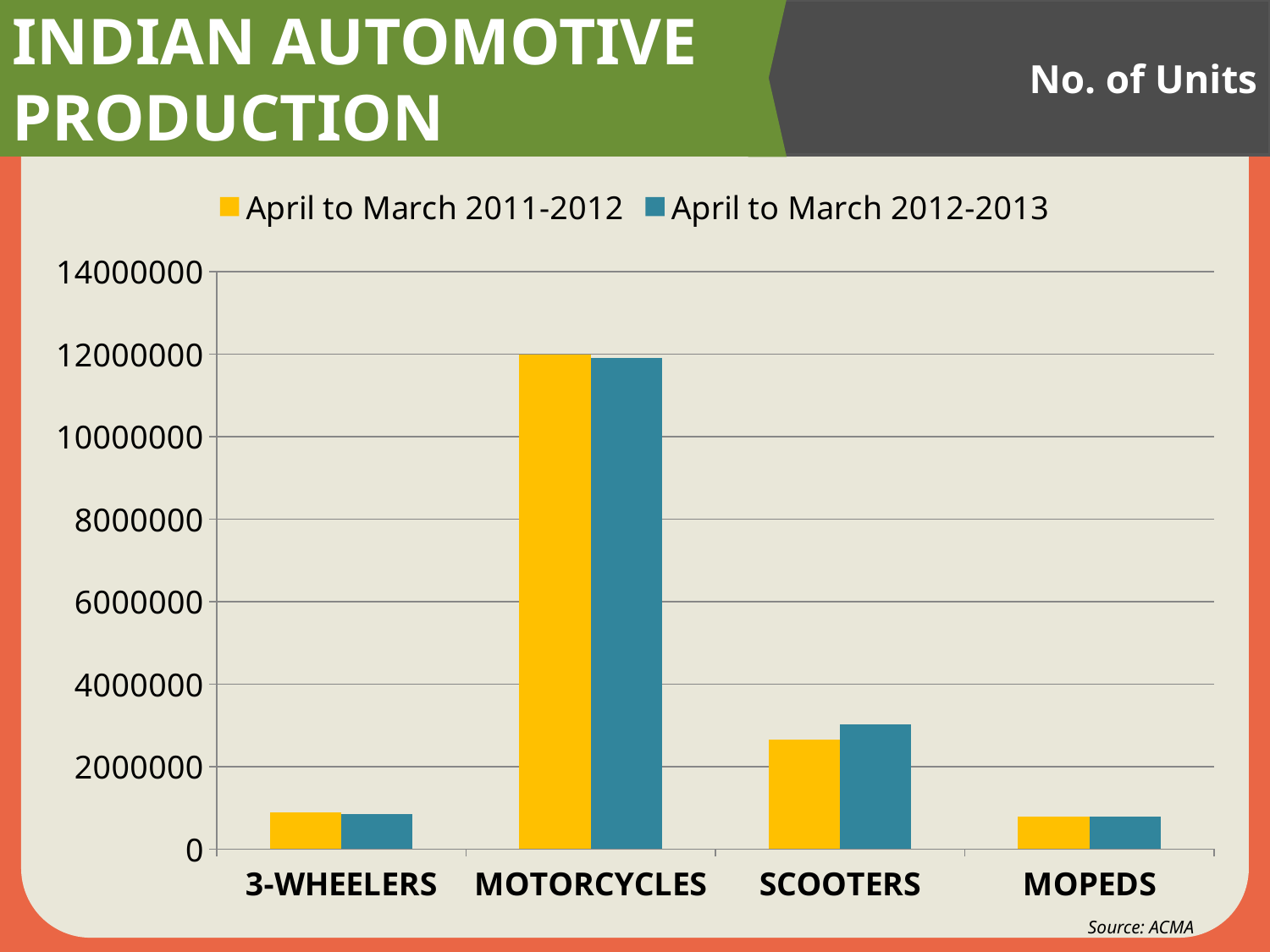
In April to March 2012-2013, which is larger, SCOOTERS or 3-WHEELERS? SCOOTERS Is the value for MOTORCYCLES in April to March 2011-2012 greater or less than 10000000? greater Is the value for SCOOTERS in April to March 2012-2013 greater or less than 4000000? less Is the value for SCOOTERS in April to March 2012-2013 greater or less than 2000000? greater What kind of chart is shown on the slide? bar chart For SCOOTERS, which period has the larger value, April to March 2011-2012 or April to March 2012-2013? April to March 2012-2013 Which category has the highest production in April to March 2011-2012? MOTORCYCLES Which category has the highest production in April to March 2012-2013? MOTORCYCLES How many vehicle categories are shown on the x axis? 4 What is the title of the chart on the slide? INDIAN AUTOMOTIVE PRODUCTION How many series does the legend list? 2